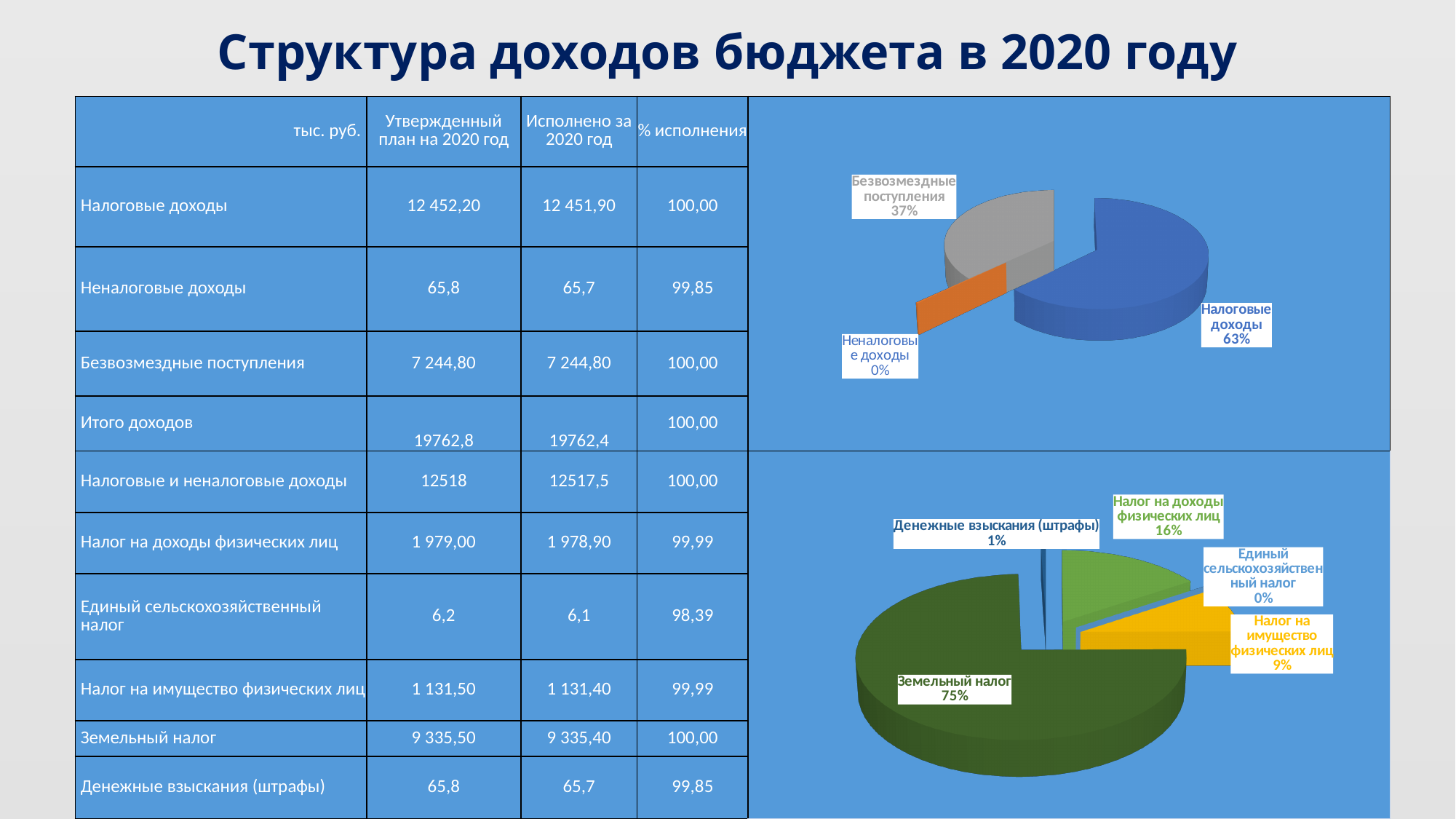
In the top pie chart, which category has the largest slice? Налоговые доходы In the top pie chart, what share is shown for Безвозмездные поступления? 37% How many slices are labelled in the top pie chart? 3 In the bottom pie chart, what share is shown for Земельный налог? 75% In the bottom pie chart, which category has the smallest slice? Единый сельскохозяйственный налог In the bottom pie chart, what is the difference in percentage points between Земельный налог and Налог на доходы физических лиц? 59 In the top pie chart, what share is shown for Неналоговые доходы? 0% How many slices are labelled in the bottom pie chart? 5 What type of chart is the top chart on the slide? Pie chart